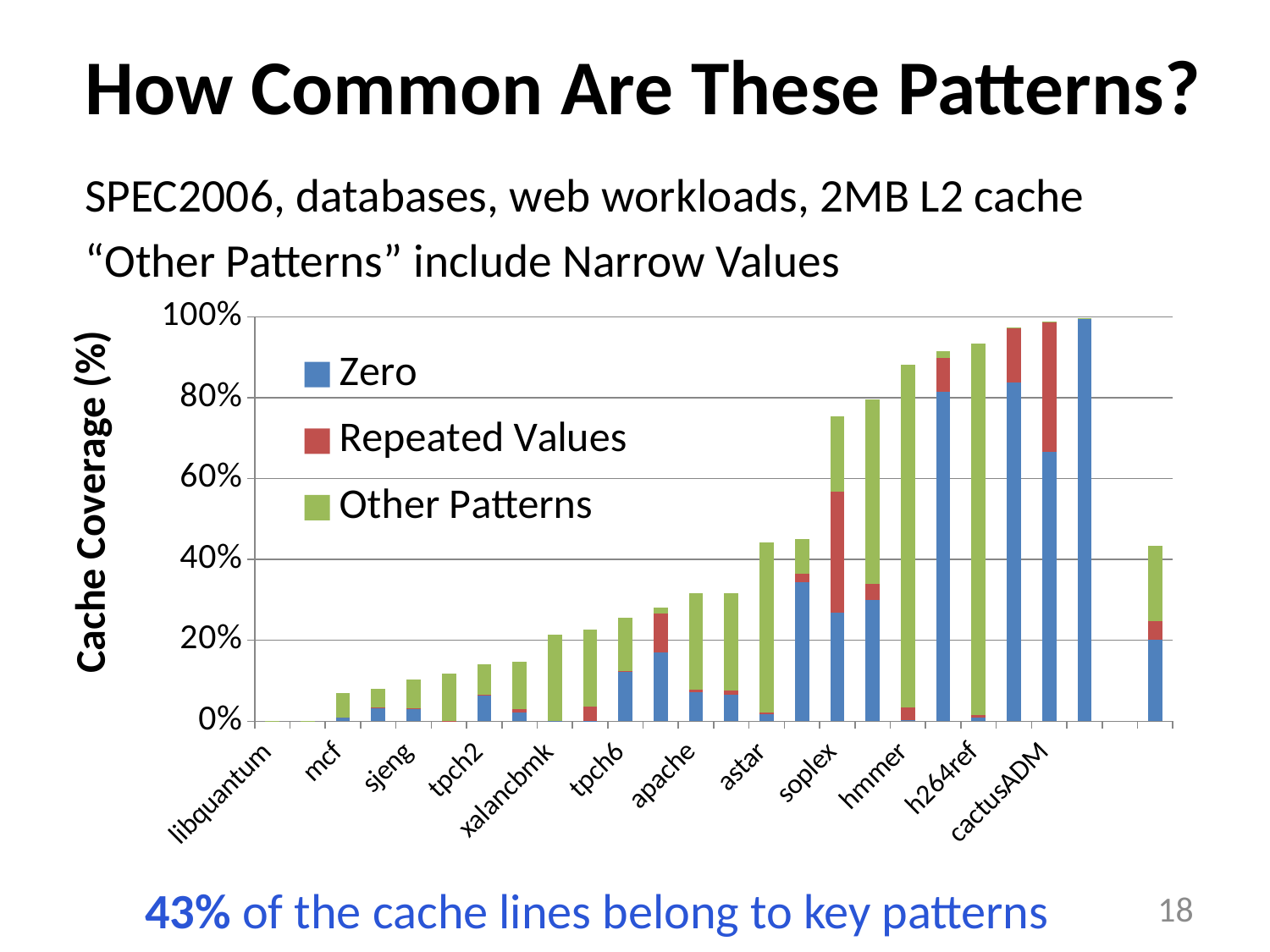
Is the total cache coverage for hmmer greater or less than 80%? greater Is the total cache coverage for apache greater or less than 40%? less What are the three series named in the legend? Zero, Repeated Values, Other Patterns Is the total cache coverage for mcf greater or less than 20%? less Do the total bar heights generally rise or fall from left to right along the x axis? rise Which labeled category has the lowest total cache coverage? libquantum Which has the larger total cache coverage, sjeng or h264ref? h264ref What kind of chart is shown on the slide? Stacked bar chart What is the label of the vertical axis? Cache Coverage (%) How many series does the legend list? 3